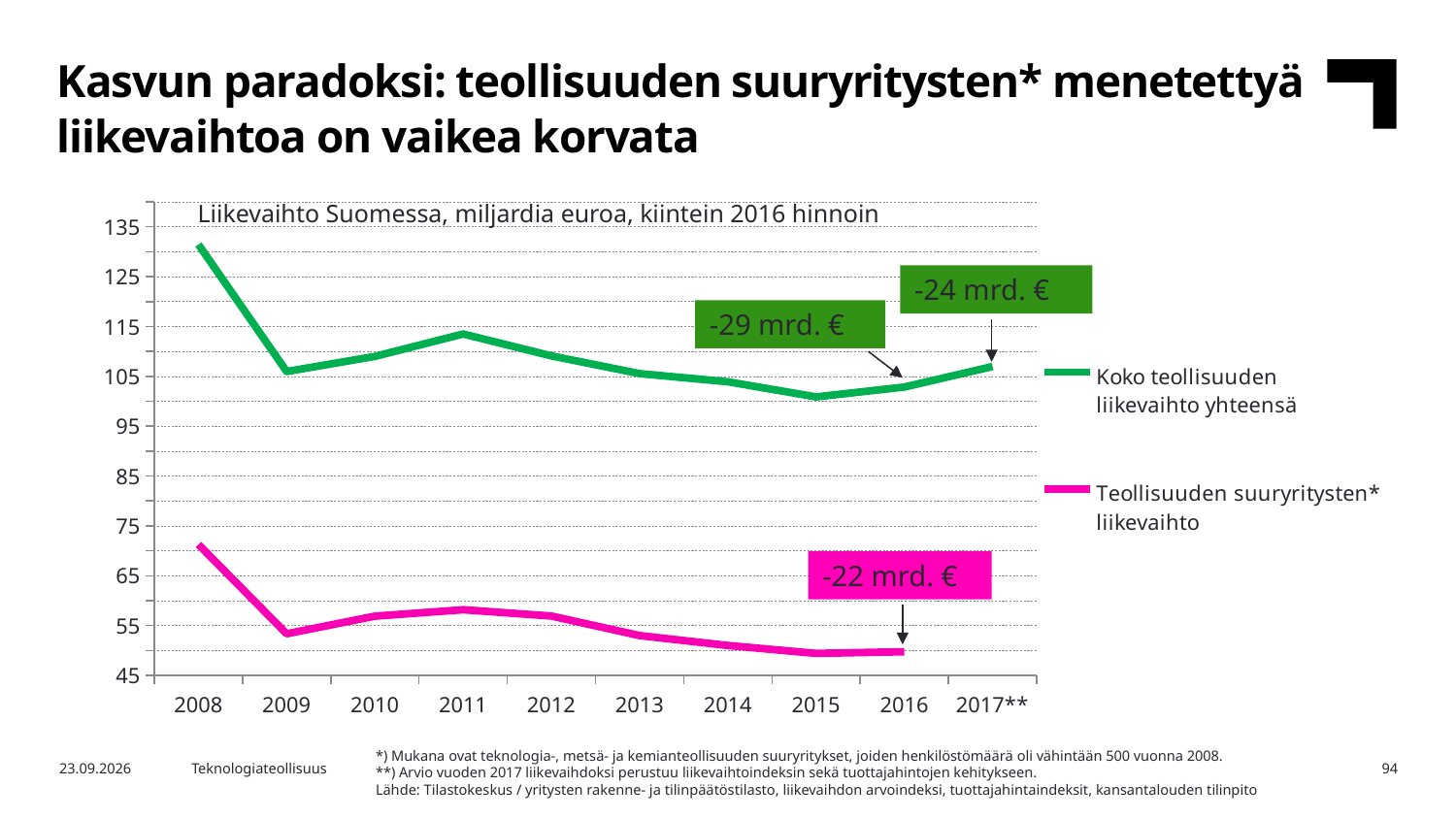
Which series is shown in green? Koko teollisuuden liikevaihto yhteensä In which year is the value for Teollisuuden suuryritysten* liikevaihto highest? 2008 In which year is the value for Koko teollisuuden liikevaihto yhteensä highest? 2008 How many series does the legend list? 2 Does the value for Koko teollisuuden liikevaihto yhteensä rise or fall from 2008 to 2009? fall Which series has the larger value in 2012, Koko teollisuuden liikevaihto yhteensä or Teollisuuden suuryritysten* liikevaihto? Koko teollisuuden liikevaihto yhteensä What kind of chart is shown on the slide? line chart How many years are shown on the x axis? 10 Is the value for Koko teollisuuden liikevaihto yhteensä in 2011 greater or less than 105? greater What is the title of the chart? Liikevaihto Suomessa, miljardia euroa, kiintein 2016 hinnoin Is the value for Koko teollisuuden liikevaihto yhteensä in 2008 greater or less than 125? greater Is the value for Teollisuuden suuryritysten* liikevaihto in 2015 greater or less than 55? less